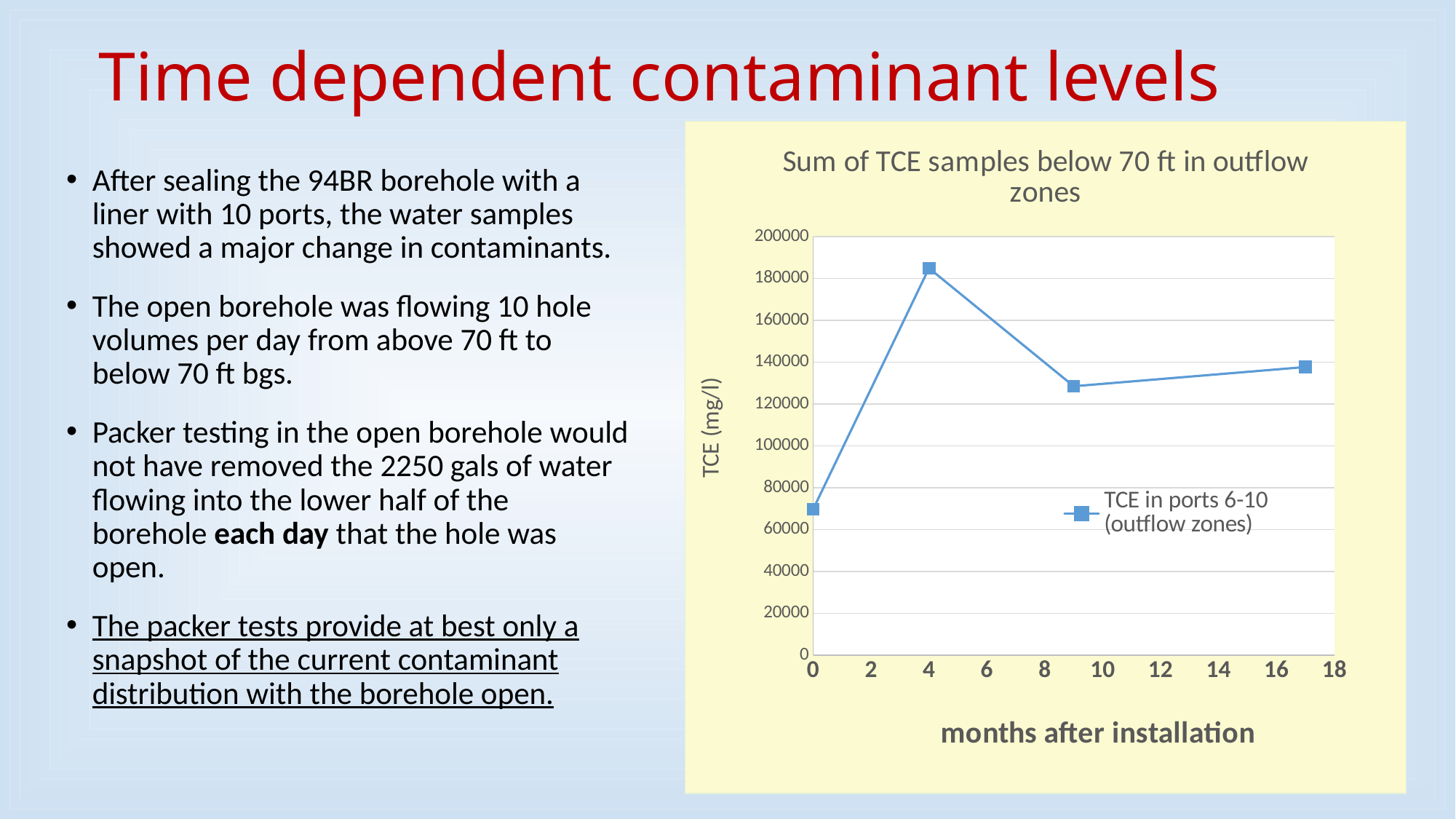
How many data points are plotted on the line? 4 What is the name of the series shown in the legend? TCE in ports 6-10 (outflow zones) How many series does the chart legend list? 1 Is the TCE value at 4 months greater or less than 180000? greater Does the TCE value rise or fall between 4 months and about 9 months after installation? fall At how many months after installation is the TCE value lowest? 0 Is the TCE value at 0 months greater or less than 80000? less Is the TCE value at the last plotted point (around 17 months) greater or less than 120000? greater What is the title of the chart? Sum of TCE samples below 70 ft in outflow zones Which is larger, the TCE value at 4 months or the TCE value at 0 months? 4 months What kind of chart is shown on the slide? line chart